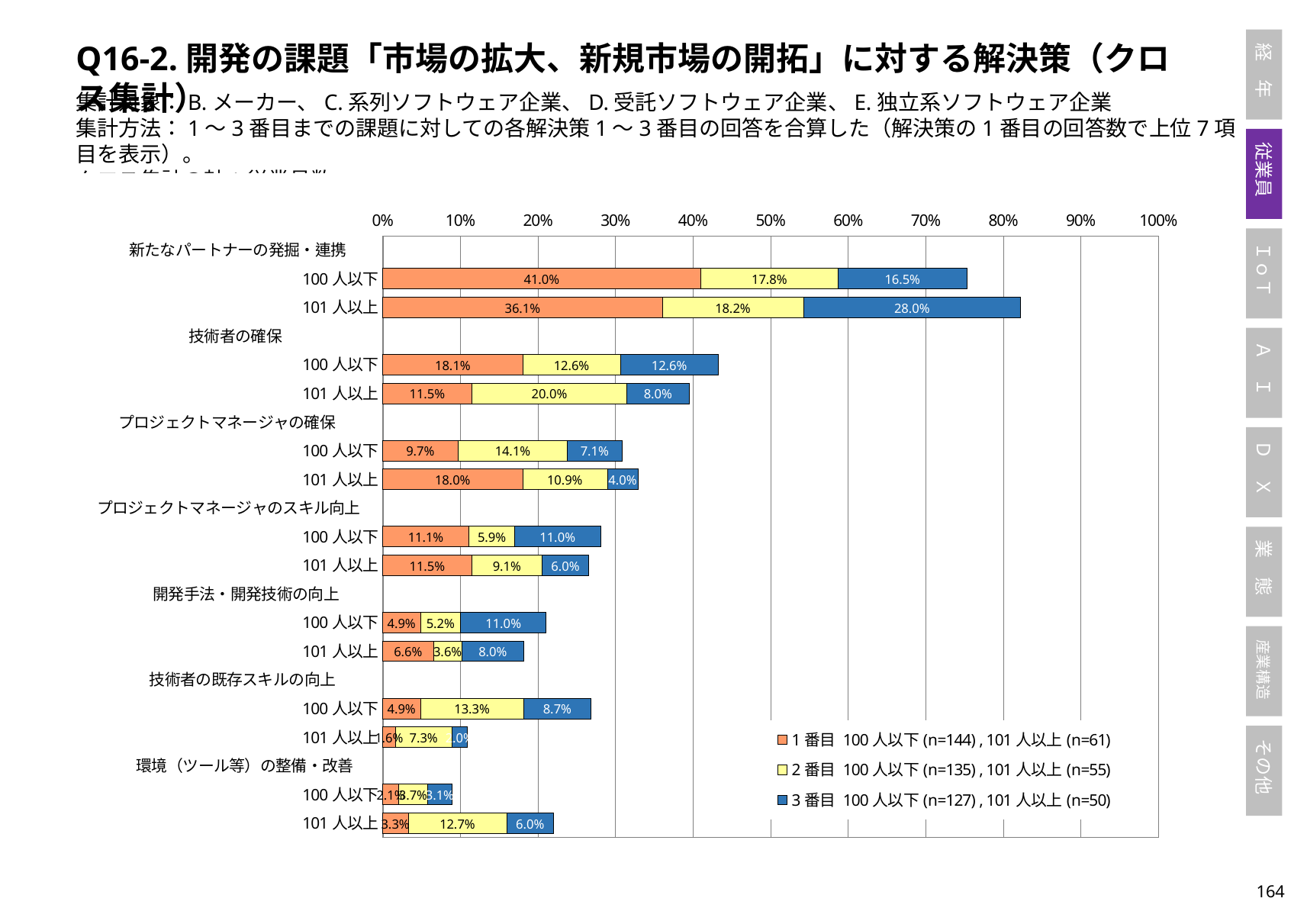
What kind of chart is shown on the slide? Stacked bar chart Which is larger: the 3番目 value for プロジェクトマネージャの確保 100人以下 or 101人以上? 100人以下 Which solution item and group has the highest 1番目 value? 新たなパートナーの発掘・連携, 100人以下 According to the legend, what is the n for 100人以下 in the 1番目 series? n=144 Is the total stacked bar for 新たなパートナーの発掘・連携, 101人以上 greater or less than 80%? greater How many series does the legend list? 3 What is the 1番目 value for 新たなパートナーの発掘・連携, 100人以下? 41.0% What is the total of the stacked bar for 新たなパートナーの発掘・連携, 100人以下? 75.3% What is the difference between the 1番目 values for 新たなパートナーの発掘・連携 between 100人以下 and 101人以上? 4.9% What is the 2番目 value for 技術者の確保, 101人以上? 20.0% What is the 3番目 value for 新たなパートナーの発掘・連携, 101人以上? 28.0% What is the 2番目 value for 環境（ツール等）の整備・改善, 101人以上? 12.7%